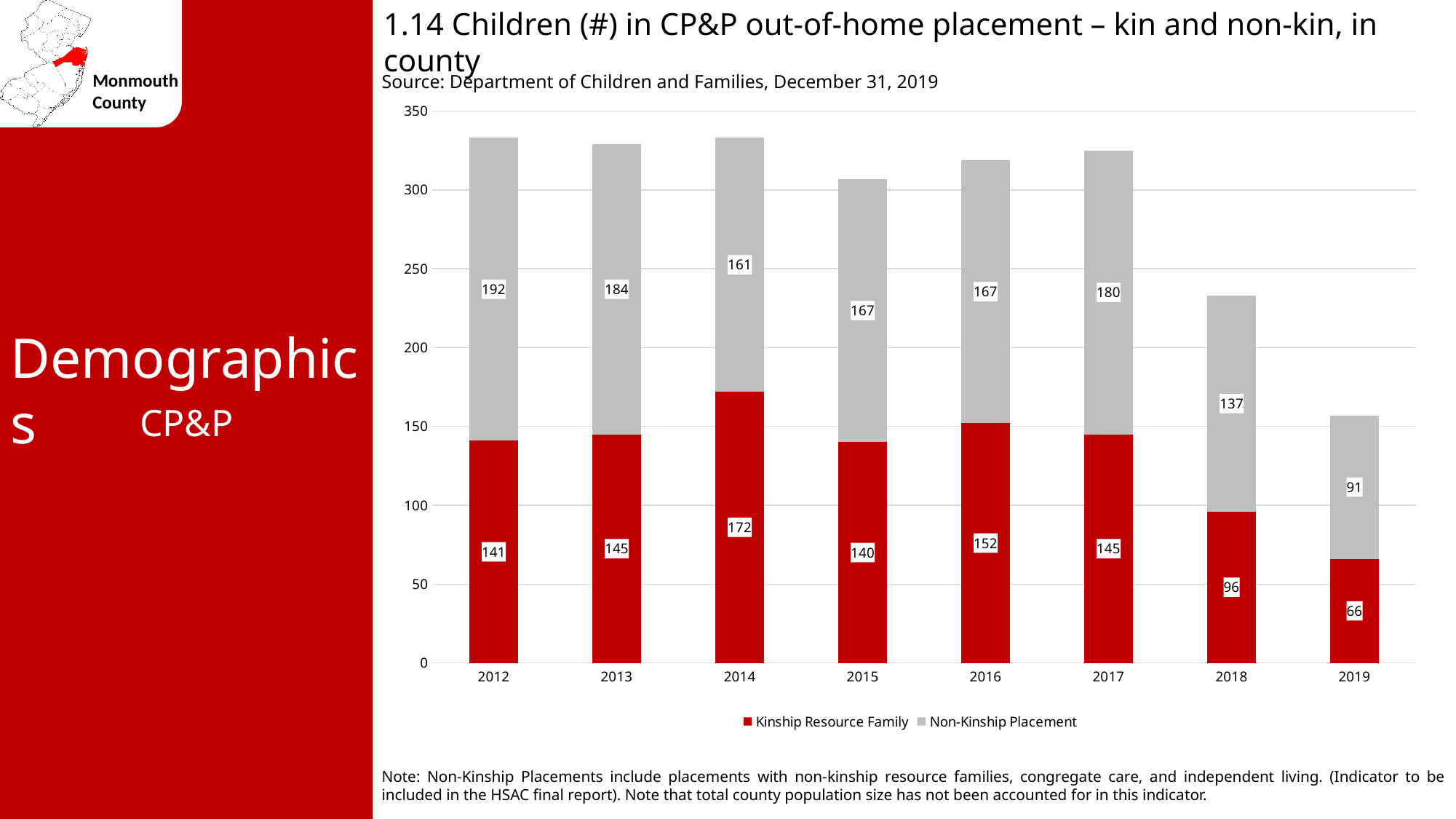
Is the total stacked bar for 2018 greater or less than 250? less How many years are shown on the x axis? 8 What is the Kinship Resource Family value for 2014? 172 What is the Non-Kinship Placement value for 2018? 137 Which year has the lowest Non-Kinship Placement value? 2019 What type of chart is shown on the slide? Stacked bar chart Which year has the highest Kinship Resource Family value? 2014 Which colour represents Kinship Resource Family in the chart? Red Which is larger in 2017: the Kinship Resource Family value or the Non-Kinship Placement value? Non-Kinship Placement What is the total number of children in out-of-home placement in 2019 (both series combined)? 157 What is the difference between the Non-Kinship Placement values for 2012 and 2019? 101 How many series does the legend list? 2